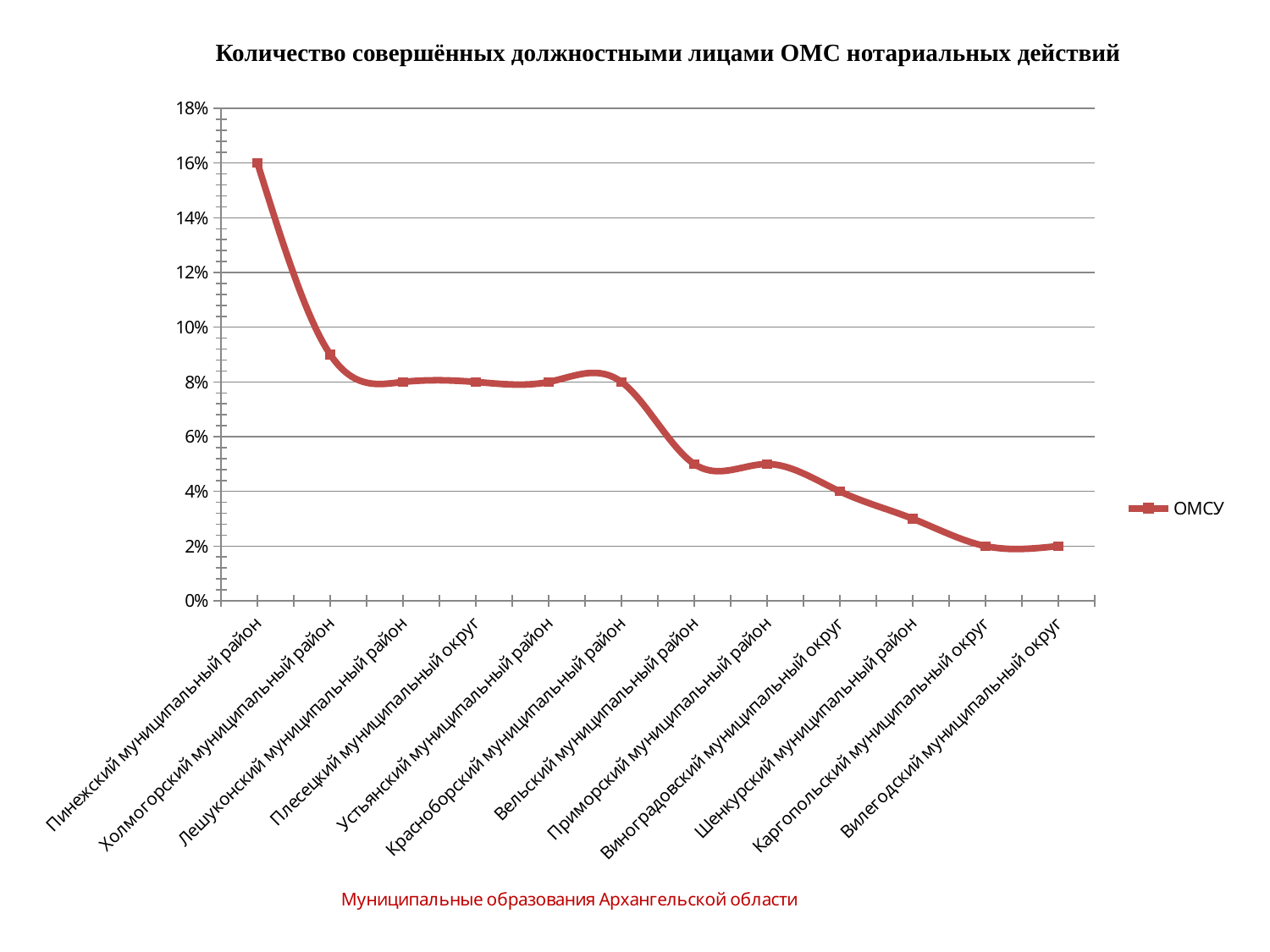
What is the value for Пинежский муниципальный район? 16% Is the value for Вельский муниципальный район greater or less than 6%? less Do the values generally rise or fall from left to right along the x axis? fall What is the value for Виноградовский муниципальный округ? 4% What kind of chart is shown on the slide? line chart What is the value for Плесецкий муниципальный округ? 8% Which is larger, the value for Пинежский муниципальный район or Холмогорский муниципальный район? Пинежский муниципальный район What is the name of the series shown in the legend? ОМСУ Which municipality has the highest value? Пинежский муниципальный район Is the value for Холмогорский муниципальный район greater or less than 8%? greater How many series does the legend list? 1 How many municipalities are plotted along the x axis? 12